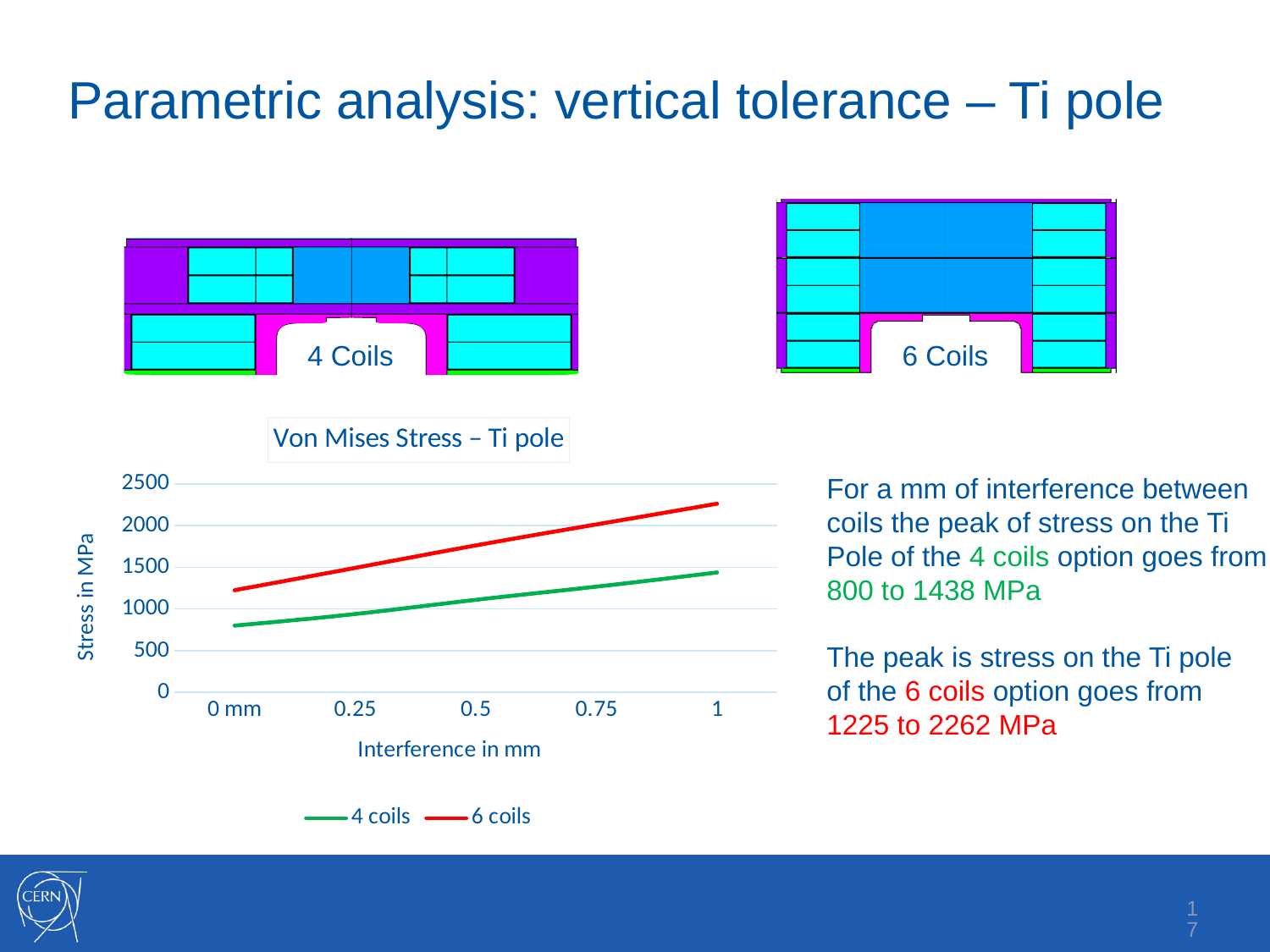
Is the stress for the 4 coils series at 0 mm interference greater or less than 1000? less Which series has the higher stress across the whole chart, 4 coils or 6 coils? 6 coils Is the stress for the 4 coils series at 0.75 mm interference greater or less than 1000? greater What kind of chart is the Von Mises Stress – Ti pole chart? line chart How many interference values are marked along the x axis of the Von Mises Stress – Ti pole chart? 5 According to the slide, what is the peak stress on the Ti pole for the 4 coils option at 1 mm of interference? 1438 MPa What is the label on the y axis of the Von Mises Stress – Ti pole chart? Stress in MPa Do the stress values for the 6 coils series rise or fall as interference increases from 0 mm to 1 mm? rise How many series does the legend of the Von Mises Stress – Ti pole chart list? 2 Is the stress for the 6 coils series at 1 mm interference greater or less than 2000? greater At 1 mm of interference, which series has the higher stress, 4 coils or 6 coils? 6 coils According to the slide, what is the peak stress on the Ti pole for the 6 coils option at 0 mm of interference? 1225 MPa